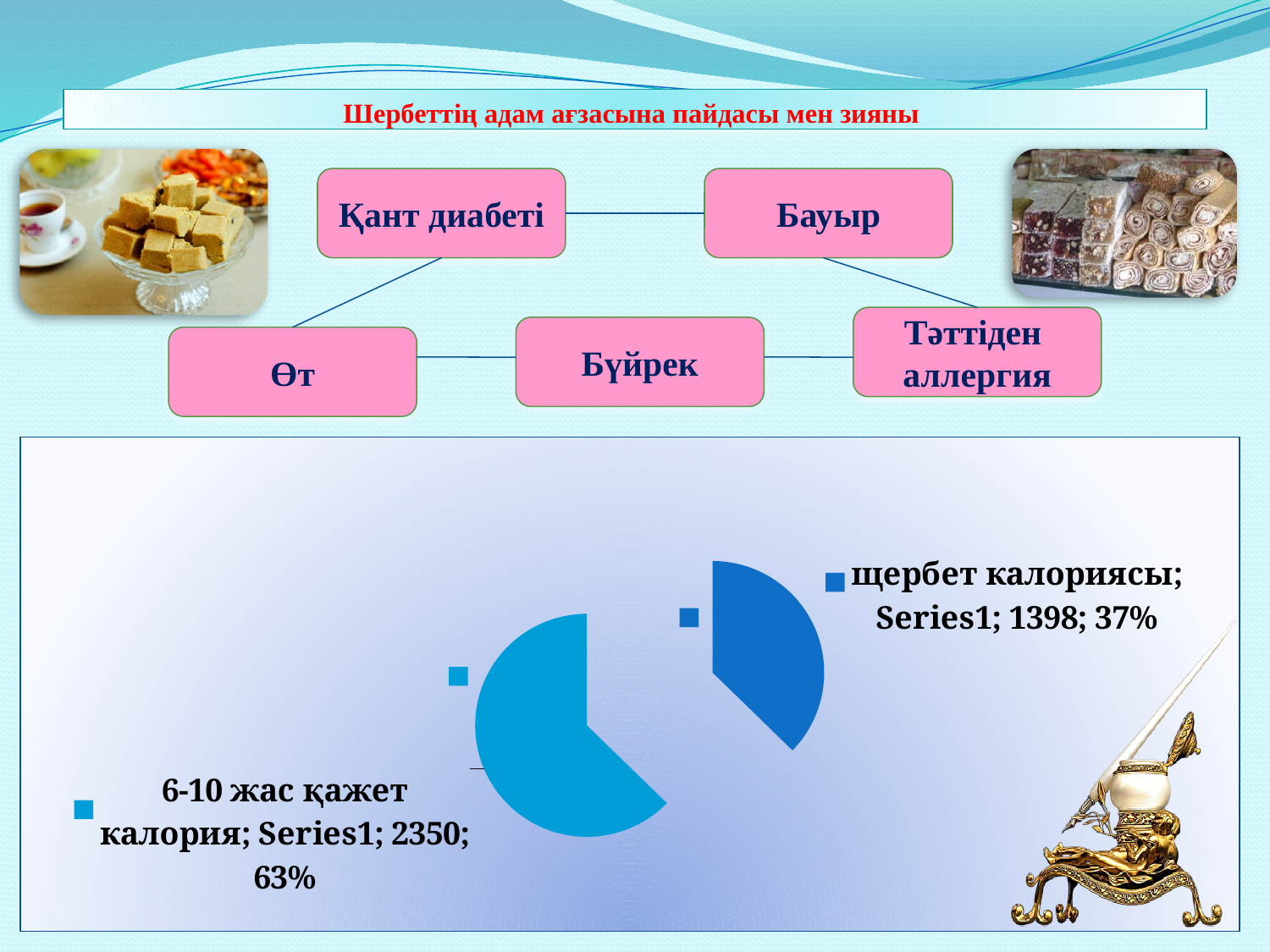
What is the value shown for "6-10 жас қажет калория" in the pie chart? 2350 How many slices does the pie chart have? 2 What kind of chart is shown at the bottom of the slide? pie chart Which slice of the pie chart is the smallest? щербет калориясы What colour is the "щербет калориясы" slice in the pie chart? dark blue What share of the pie does "щербет калориясы" represent? 37% What is the total of the two values shown in the pie chart? 3748 Which slice of the pie chart is the largest? 6-10 жас қажет калория What share of the pie does "6-10 жас қажет калория" represent? 63% What is the difference between the values for "6-10 жас қажет калория" and "щербет калориясы"? 952 What is the value shown for "щербет калориясы" in the pie chart? 1398 Which is larger in the pie chart: "щербет калориясы" or "6-10 жас қажет калория"? 6-10 жас қажет калория